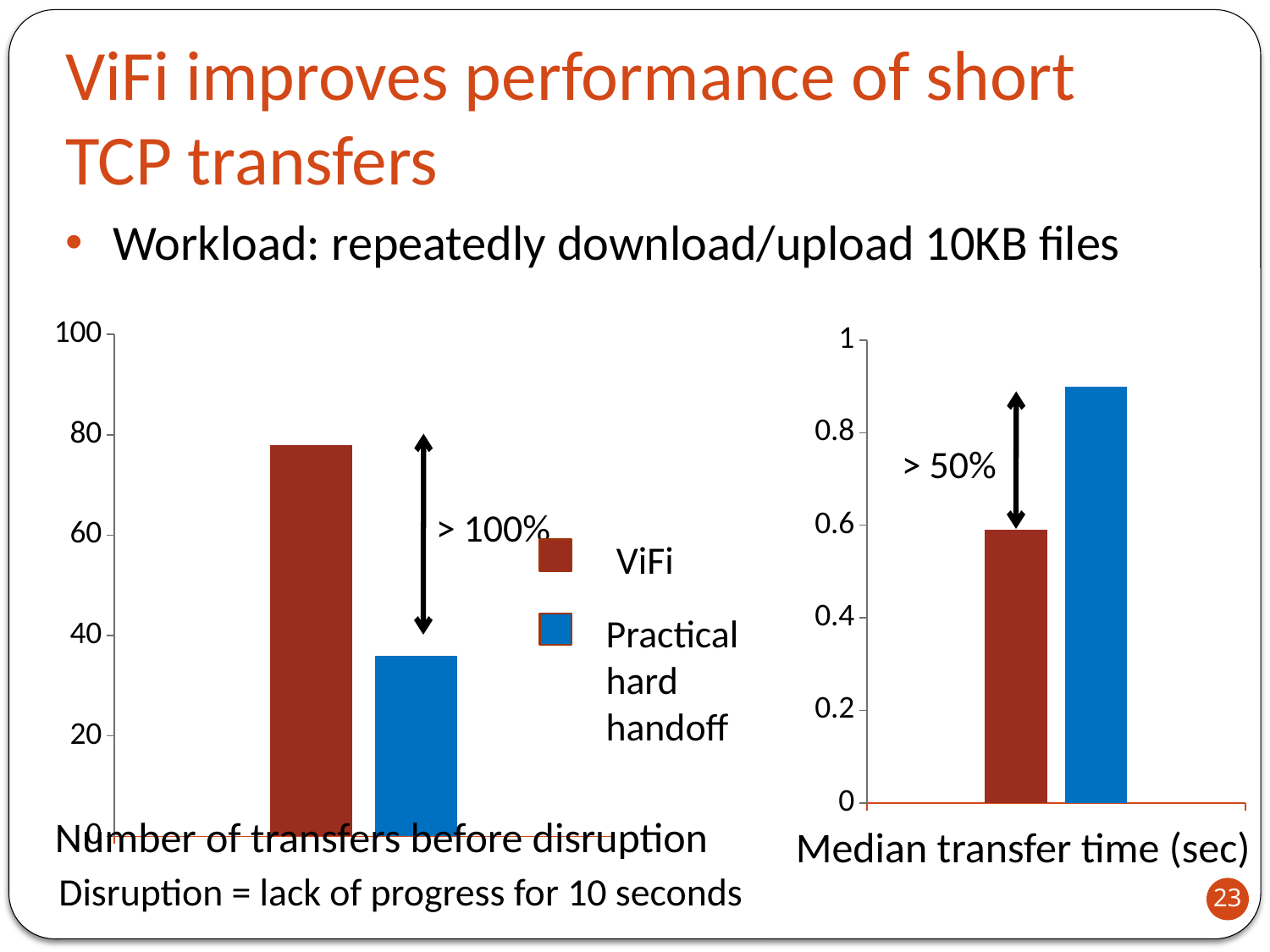
What colour are the ViFi bars in the charts? red In the left chart, 'Number of transfers before disruption', is the value for ViFi greater or less than 60? greater In the left chart, 'Number of transfers before disruption', which series has the higher value, ViFi or Practical hard handoff? ViFi In the right chart, 'Median transfer time (sec)', which series has the highest bar? Practical hard handoff What percentage annotation is shown between the bars in the left chart, 'Number of transfers before disruption'? > 100% How many series does the legend list? 2 In the left chart, 'Number of transfers before disruption', is the value for Practical hard handoff greater or less than 40? less What kind of chart is the left chart, 'Number of transfers before disruption'? bar chart In the right chart, 'Median transfer time (sec)', which series has the lower value, ViFi or Practical hard handoff? ViFi What kind of chart is the right chart, 'Median transfer time (sec)'? bar chart In the right chart, 'Median transfer time (sec)', is the value for Practical hard handoff greater or less than 0.8? greater